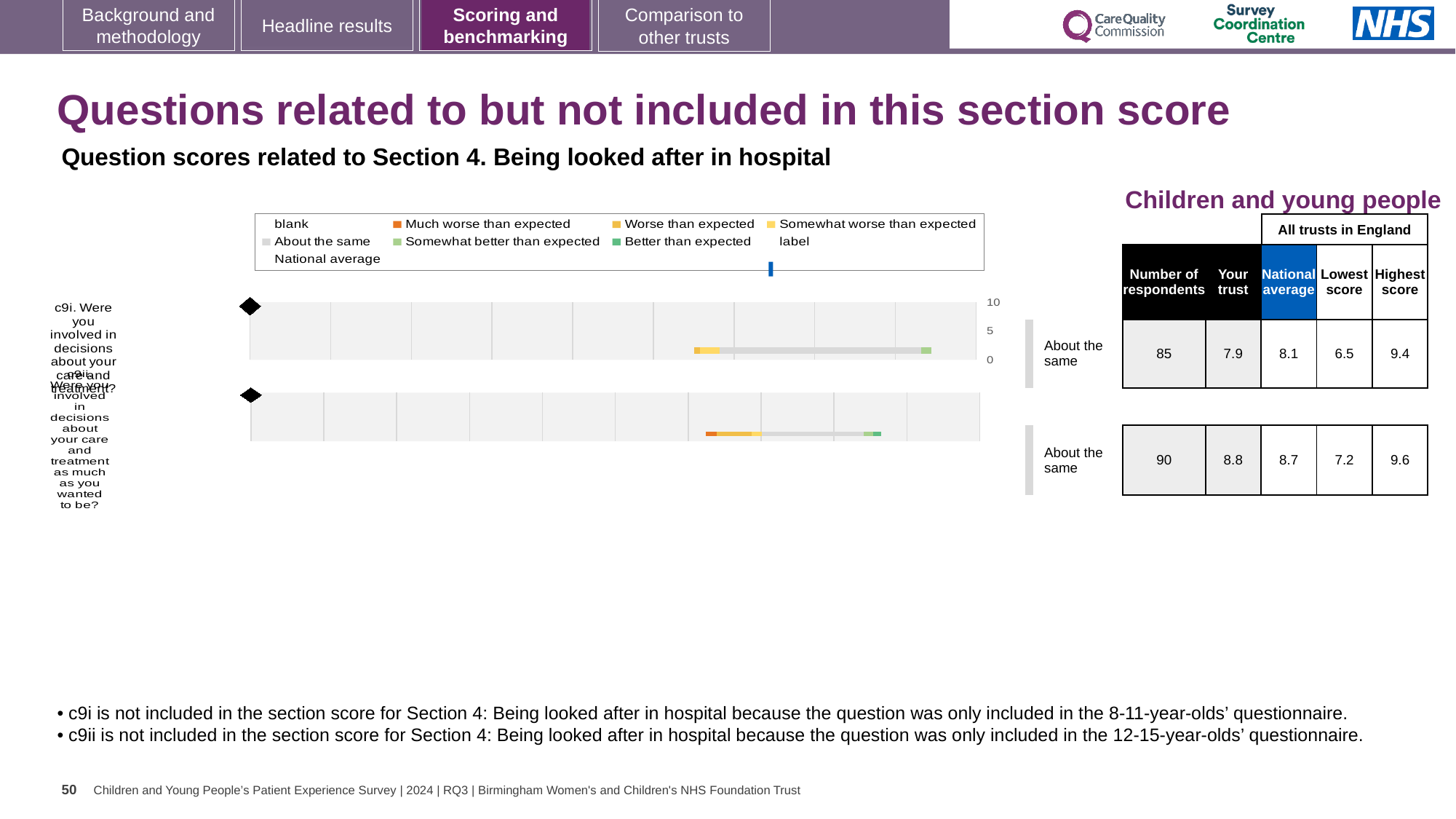
Which question has the higher 'Your trust' score, c9i or c9ii? c9ii How many respondents answered question c9ii? 90 What kind of chart is shown on the slide? bar chart What is the difference between the highest score and the lowest score for question c9i? 2.9 What is the national average score for question c9ii? 8.7 What is the difference between the 'Your trust' score and the national average for question c9i? 0.2 What colour does the legend use for 'Better than expected'? green How many questions (categories) are plotted in the chart? 2 How many entries does the chart legend list? 9 What is the lowest score across all trusts in England for question c9ii? 7.2 What is the 'Your trust' score for question c9i? 7.9 What benchmark category is shown for question c9i? About the same